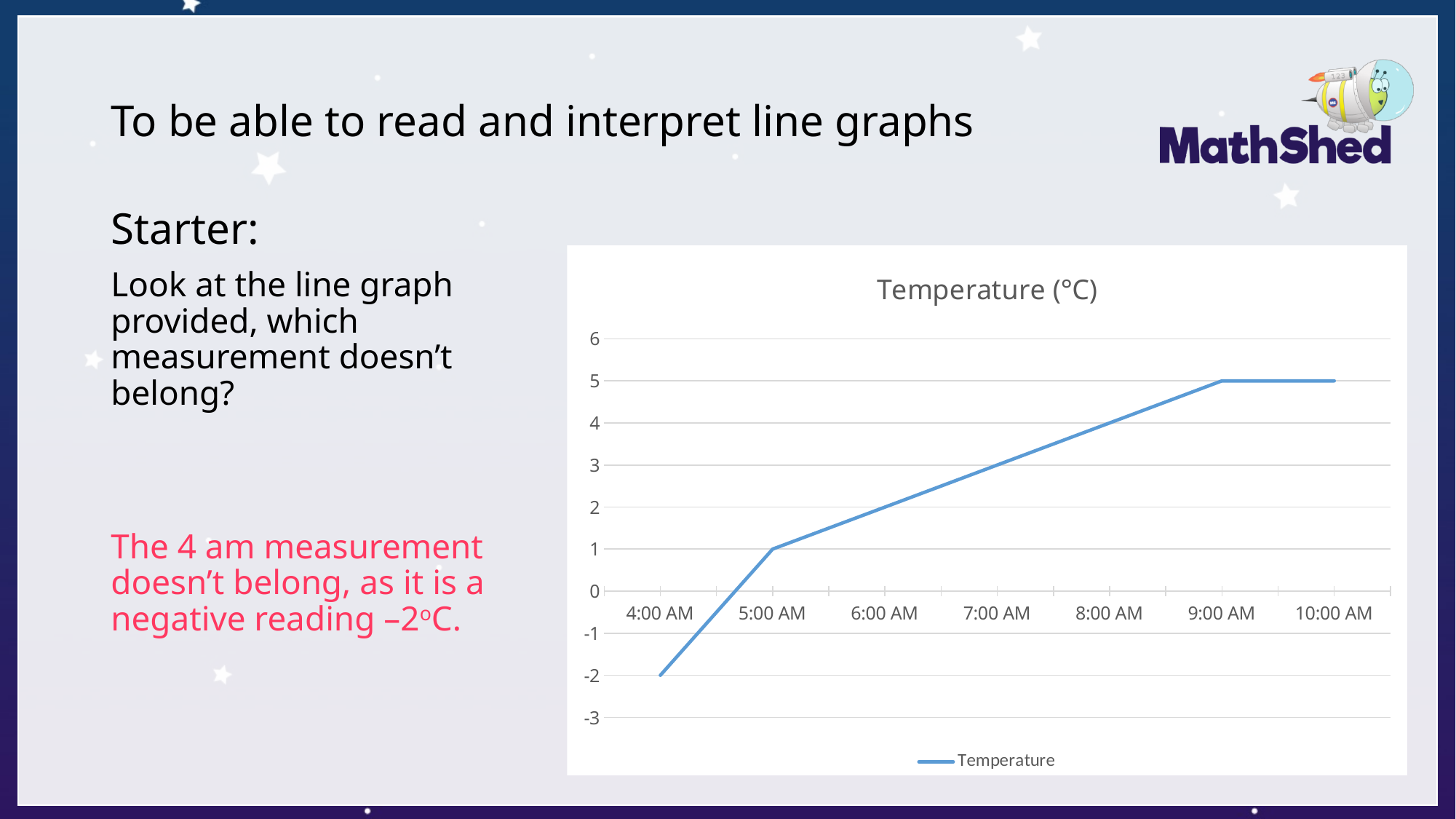
What is the temperature at 10:00 AM? 5 What type of chart is shown on the slide? line chart What is the temperature at 5:00 AM? 1 What is the difference between the temperature at 9:00 AM and at 5:00 AM? 4 What is the temperature at 4:00 AM? -2 How many series does the legend list? 1 Is the temperature at 6:00 AM greater or less than 1? greater How many time points are plotted on the chart? 7 At which time is the temperature lowest? 4:00 AM Is the temperature at 8:00 AM greater or less than 3? greater What is the title of the chart? Temperature (°C) What is the temperature at 9:00 AM? 5